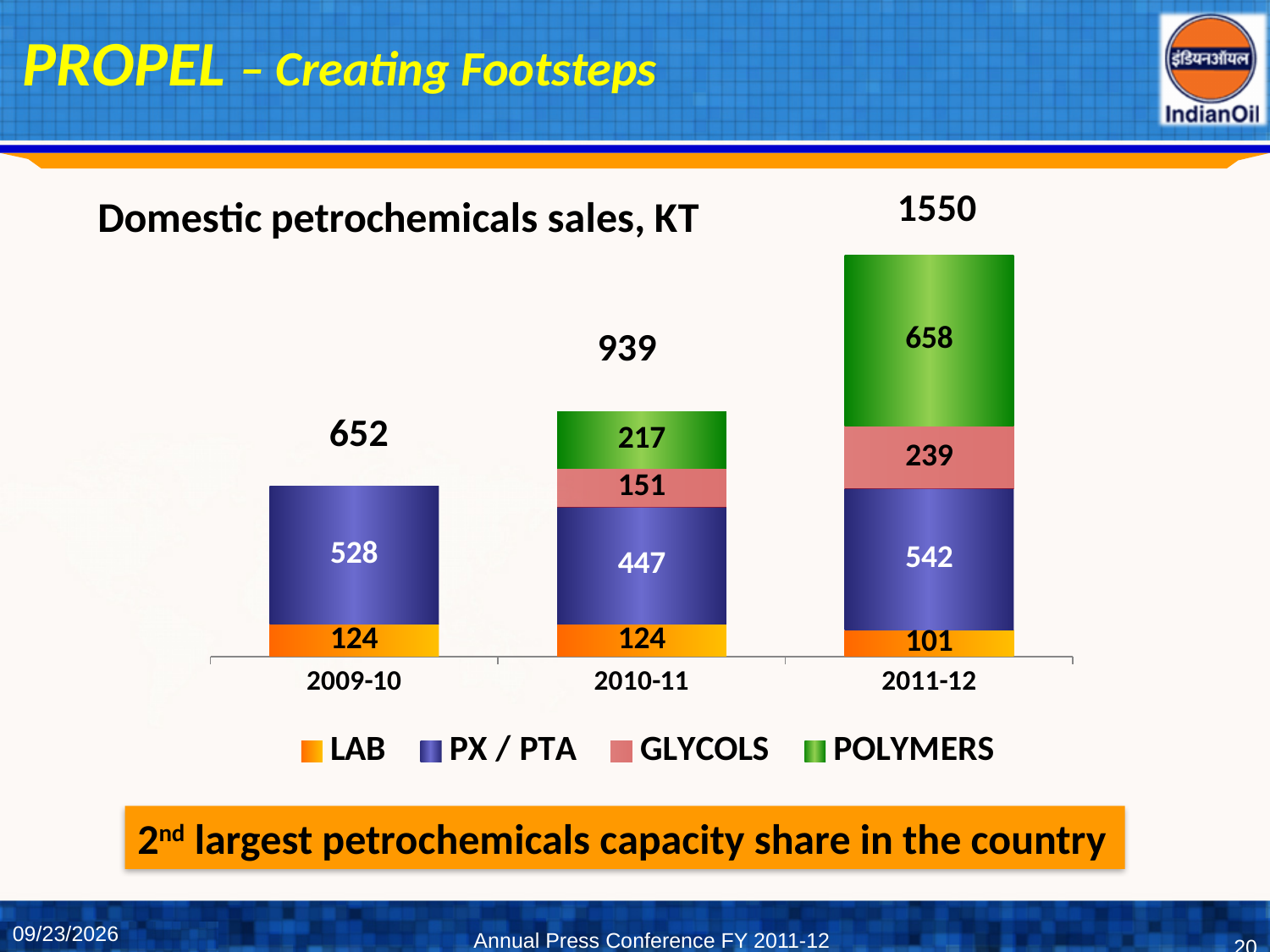
What is the GLYCOLS value for 2010-11? 151 Which year has the highest total domestic petrochemicals sales? 2011-12 How many years are shown on the x axis? 3 Which year has the lowest total domestic petrochemicals sales? 2009-10 What is the LAB value for 2011-12? 101 What is the PX / PTA value for 2010-11? 447 What is the POLYMERS value for 2011-12? 658 How many series does the legend list? 4 What is the difference between the total sales in 2011-12 and 2010-11? 611 What is the total domestic petrochemicals sales for 2010-11? 939 Do the total sales rise or fall from 2009-10 to 2011-12? rise Which is larger, the PX / PTA value for 2009-10 or for 2011-12? 2011-12